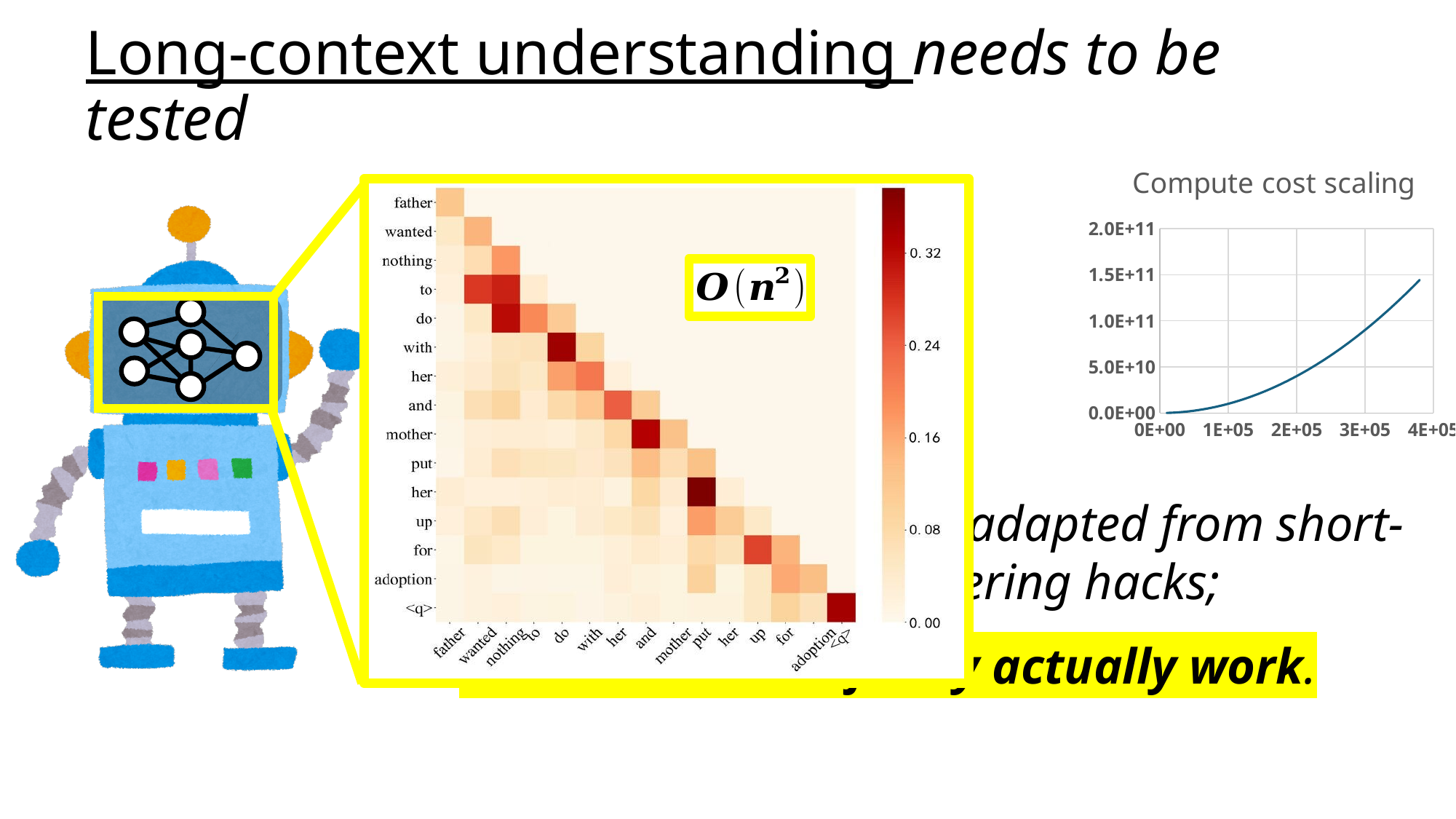
In the heatmap on the left, what is the highest value labelled on the colour bar? 0.32 What is the title of the line chart on the right of the slide? Compute cost scaling In the 'Compute cost scaling' chart, how many tick labels are shown on the x axis? 5 In the 'Compute cost scaling' chart, do the values rise or fall as the x axis increases? rise In the 'Compute cost scaling' chart, is the value at x = 2E+05 greater or less than 5.0E+10? less In the heatmap on the left, what is the first token listed at the top of the vertical axis? father In the heatmap on the left, how many tokens are listed along the vertical axis? 15 In the 'Compute cost scaling' chart, is the highest point of the line greater or less than 1.0E+11? greater What kind of chart is the 'Compute cost scaling' chart on the right of the slide? line chart What kind of chart is shown inside the yellow box on the left of the slide? heatmap In the 'Compute cost scaling' chart, is the value at x = 1E+05 greater or less than 5.0E+10? less In the 'Compute cost scaling' chart, what is the highest value labelled on the y axis? 2.0E+11